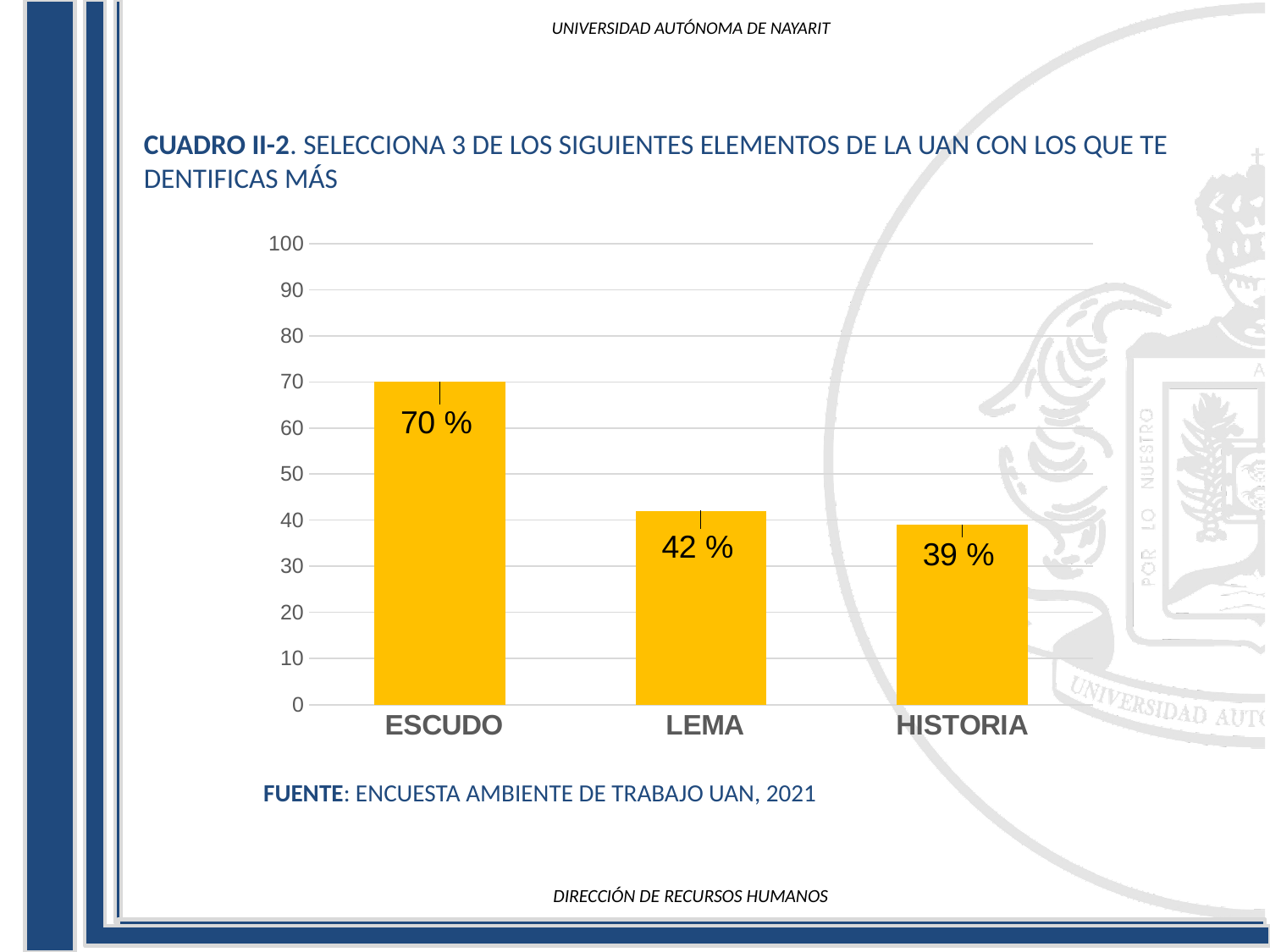
What is the difference between the values for LEMA and HISTORIA? 3 % What is the value for LEMA? 42 % Which category has the highest value? ESCUDO Is the value for ESCUDO greater or less than 60? greater Do the values rise or fall from left to right along the x axis? fall What is the value for ESCUDO? 70 % Which is larger, the value for ESCUDO or the value for HISTORIA? ESCUDO What kind of chart is shown on the slide? bar chart How many categories are shown on the x axis? 3 What is the difference between the values for ESCUDO and LEMA? 28 % Which category has the lowest value? HISTORIA What is the value for HISTORIA? 39 %